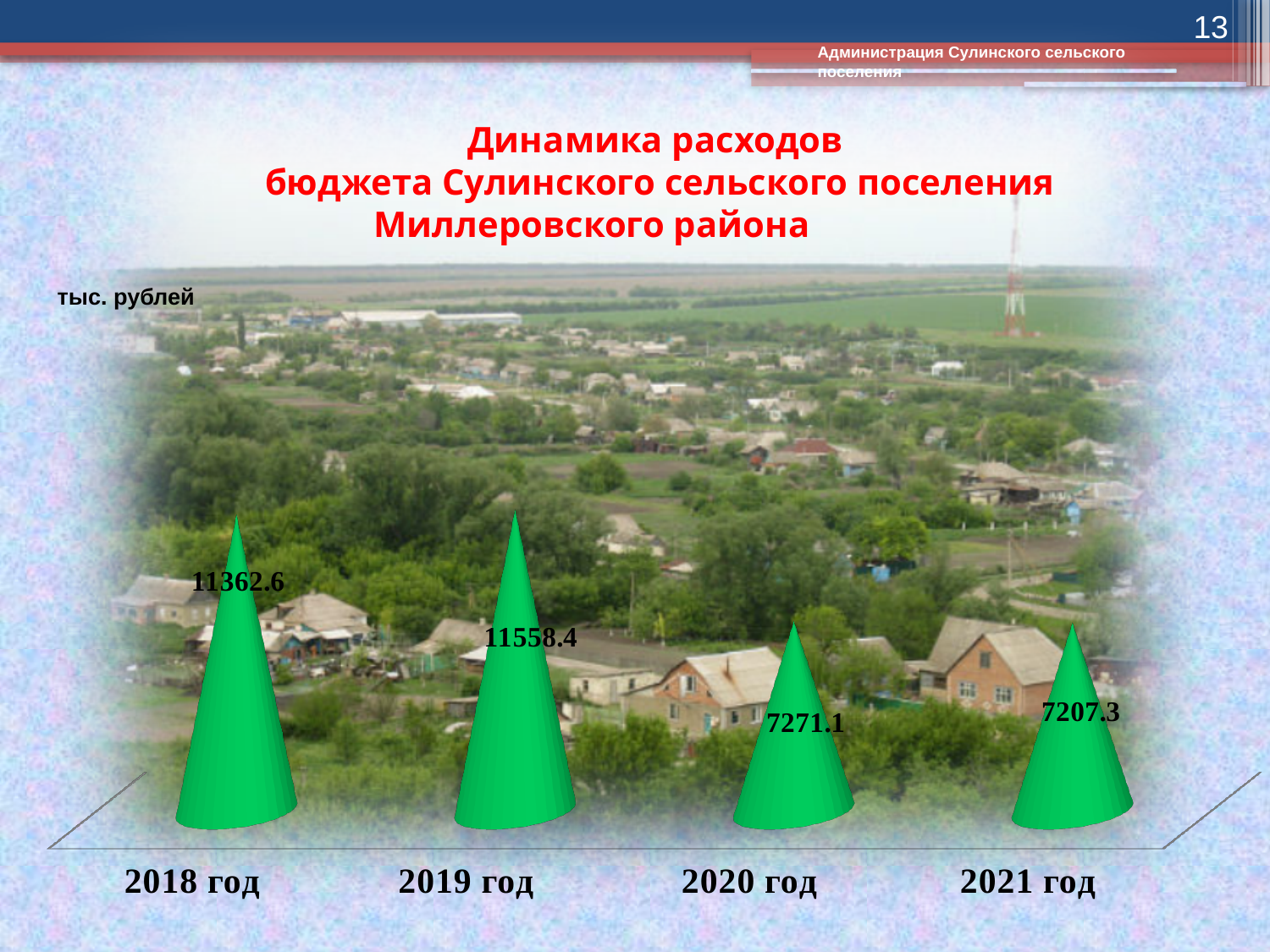
What is the difference between the values for 2020 год and 2021 год? 63.8 What kind of chart is shown on the slide? bar chart Which year has the highest value? 2019 год What is the value for 2018 год? 11362.6 What is the value for 2021 год? 7207.3 What is the difference between the values for 2019 год and 2018 год? 195.8 What is the value for 2020 год? 7271.1 Which year has the lowest value? 2021 год What is the value for 2019 год? 11558.4 What unit of measurement is indicated for the chart values? тыс. рублей Which is larger, the value for 2018 год or the value for 2020 год? 2018 год How many years are shown on the chart? 4